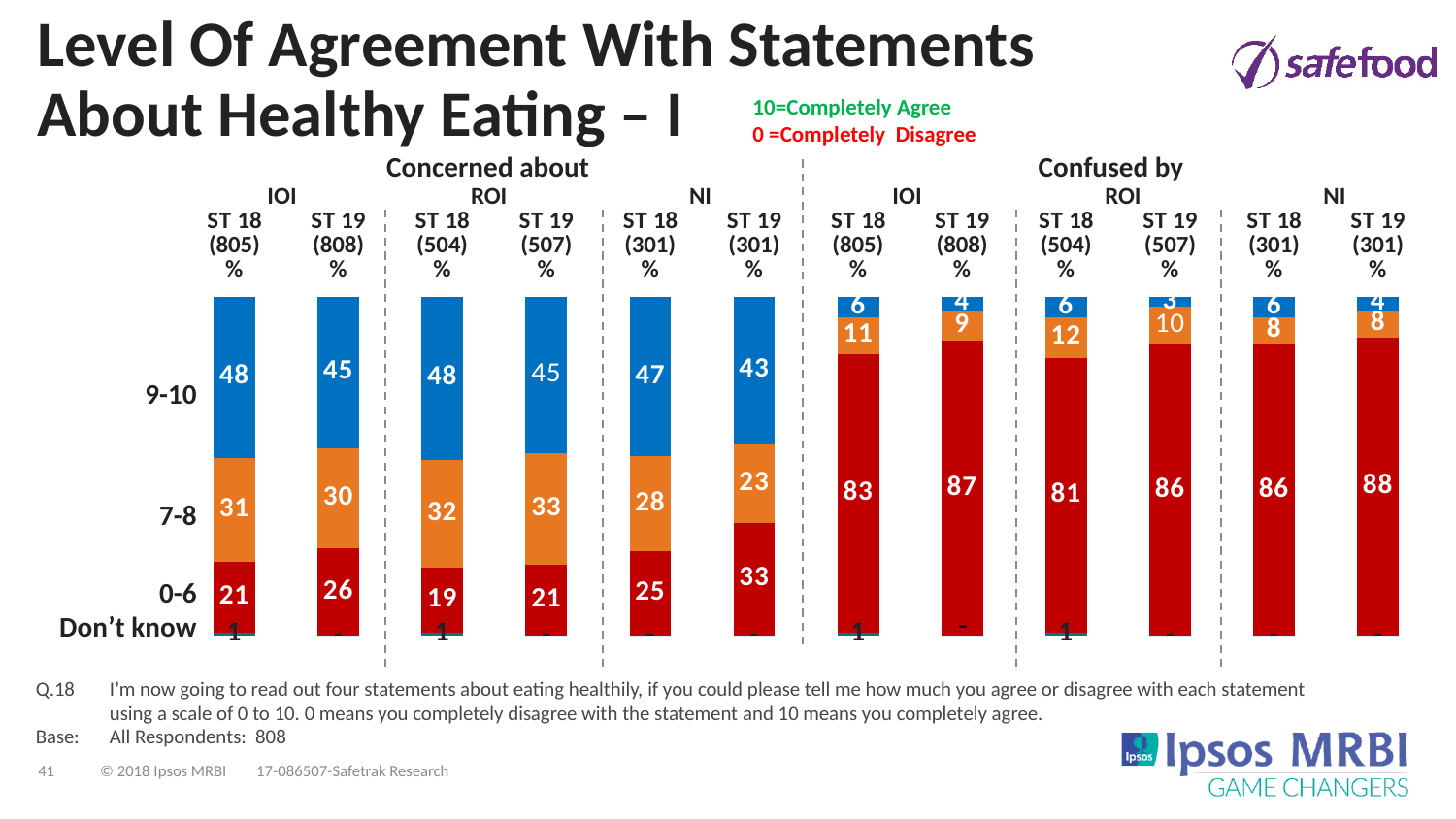
In the 'Confused by' section, what percentage of NI ST 19 respondents gave a 0-6 rating? 88 In the 'Concerned about' section, which bar has the highest 0-6 value? NI ST 19 What type of chart is shown on the slide? Stacked bar chart How many bars are shown in the chart in total? 12 In the 'Concerned about' section, what is the difference between the 9-10 values for NI ST 18 and NI ST 19? 4 In the 'Concerned about' section, what percentage of IOI ST 18 respondents gave a 9-10 rating? 48 In the 'Confused by' section, which is larger: the 0-6 value for IOI ST 19 or for ROI ST 19? IOI ST 19 In the 'Concerned about' section, did the 9-10 value for IOI rise or fall from ST 18 to ST 19? Fall In the 'Concerned about' section, what is the 7-8 value for ROI ST 19? 33 What is the base (number of respondents) shown for ST 19 in the IOI columns? 808 In the 'Confused by' section, which bar has the lowest 0-6 value? ROI ST 18 In the 'Confused by' section, what is the 7-8 value for ROI ST 18? 12